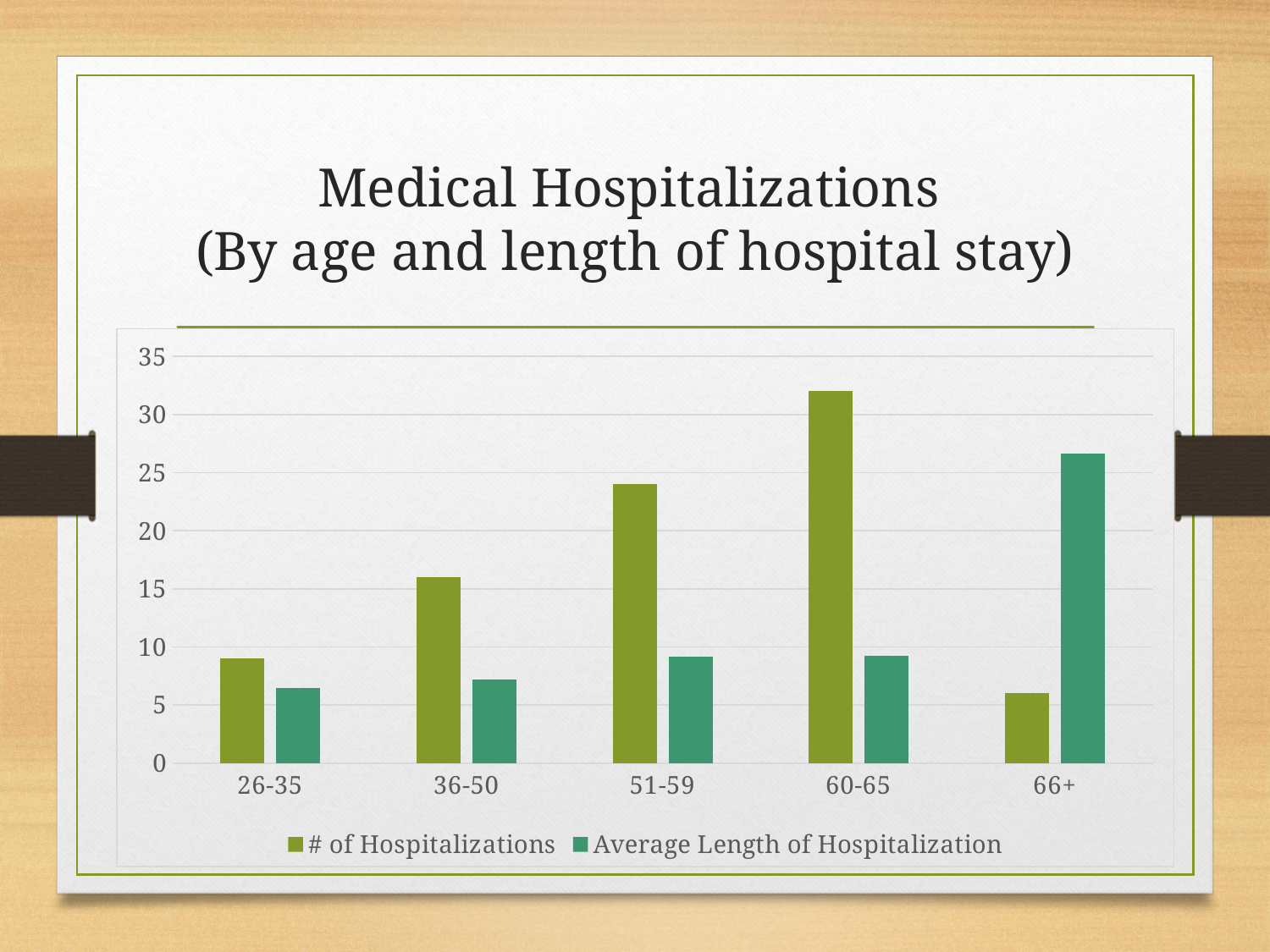
Is the number of hospitalizations for the 60-65 age group greater or less than 30? greater Which age group has the lowest average length of hospitalization? 26-35 How many age groups are shown on the x axis? 5 Which age group has the highest average length of hospitalization? 66+ For the 66+ age group, which is larger: the number of hospitalizations or the average length of hospitalization? Average Length of Hospitalization How many series does the legend list? 2 What is the title of the chart on the slide? Medical Hospitalizations (By age and length of hospital stay) Which age group has the lowest number of hospitalizations? 66+ Which age group has the highest number of hospitalizations? 60-65 Is the average length of hospitalization for the 66+ age group greater or less than 25? greater What kind of chart is shown on the slide? bar chart Is the number of hospitalizations for the 36-50 age group greater or less than 20? less